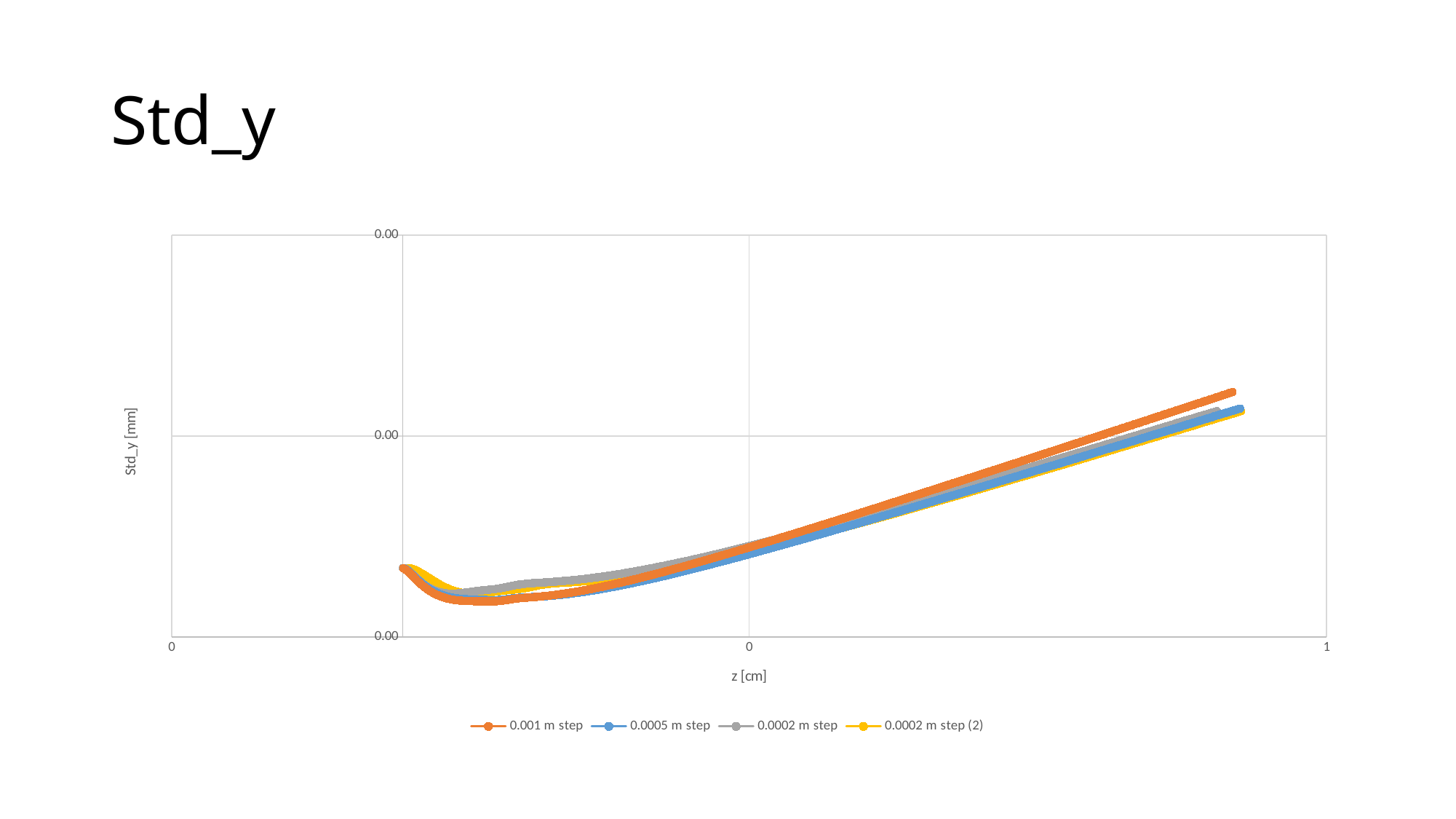
What is the label of the x axis? z [cm] At the right end of the chart, is the value for the 0.001 m step series larger or smaller than the value for the 0.0002 m step (2) series? larger Which series reaches the highest value at the right end of the chart? 0.001 m step What kind of chart is shown on the slide? line chart How many series does the legend list? 4 Do the plotted values generally rise or fall as z increases across the right half of the chart? rise What is the title of the slide containing the chart? Std_y Which series is drawn in orange? 0.001 m step